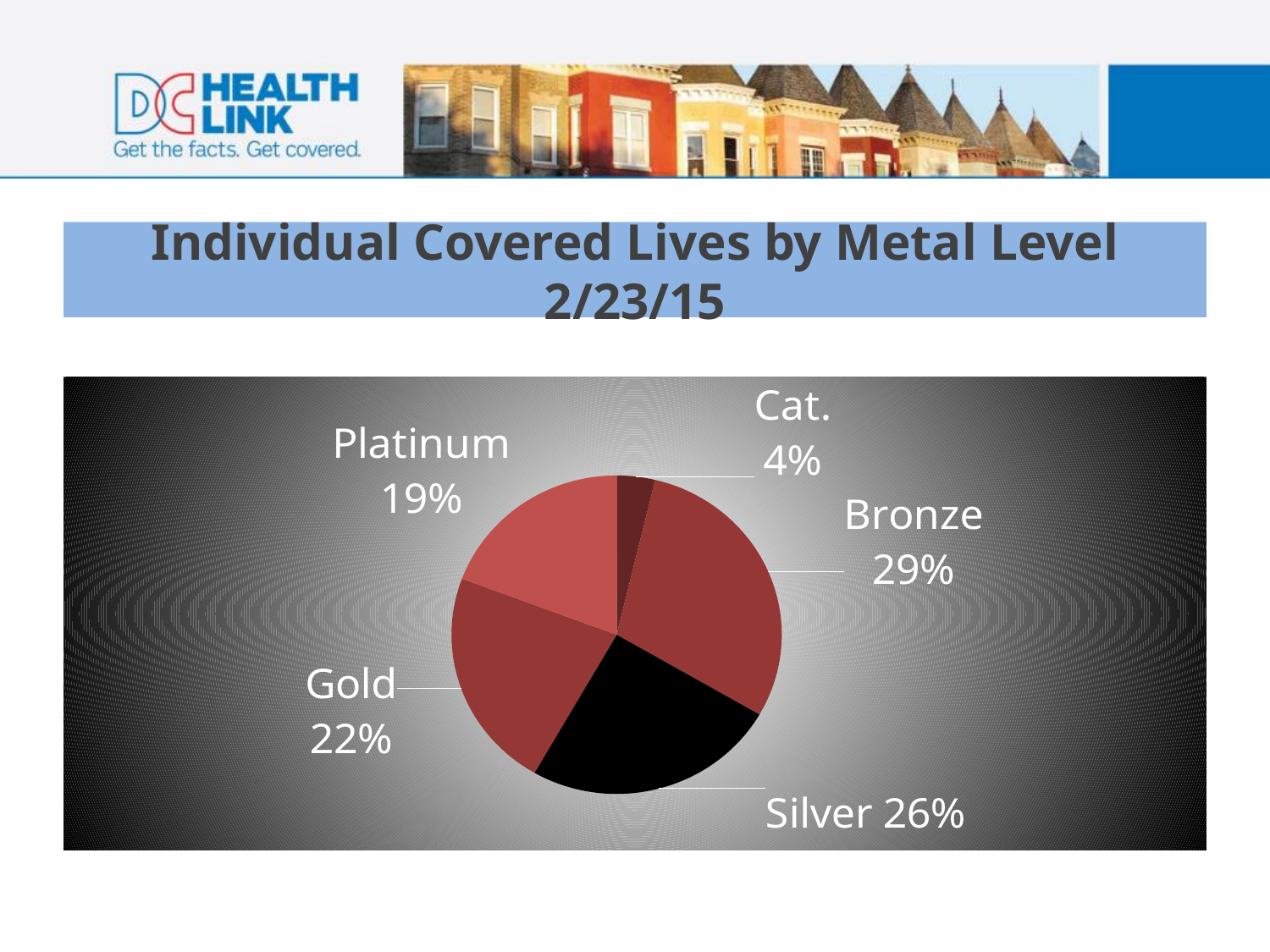
What share of individual covered lives is at the Cat. level? 4% Which has a larger share, Gold or Silver? Silver What share of individual covered lives is at the Silver metal level? 26% What share of individual covered lives is at the Platinum metal level? 19% What type of chart is shown on the slide? Pie chart What is the title of the chart on the slide? Individual Covered Lives by Metal Level 2/23/15 Which category has the smallest share of individual covered lives? Cat. Which metal level has the largest share of individual covered lives? Bronze What share of individual covered lives is at the Bronze metal level? 29% What is the difference in percentage points between the Bronze and Platinum shares? 10 What share of individual covered lives is at the Gold metal level? 22% How many categories are shown in the pie chart? 5